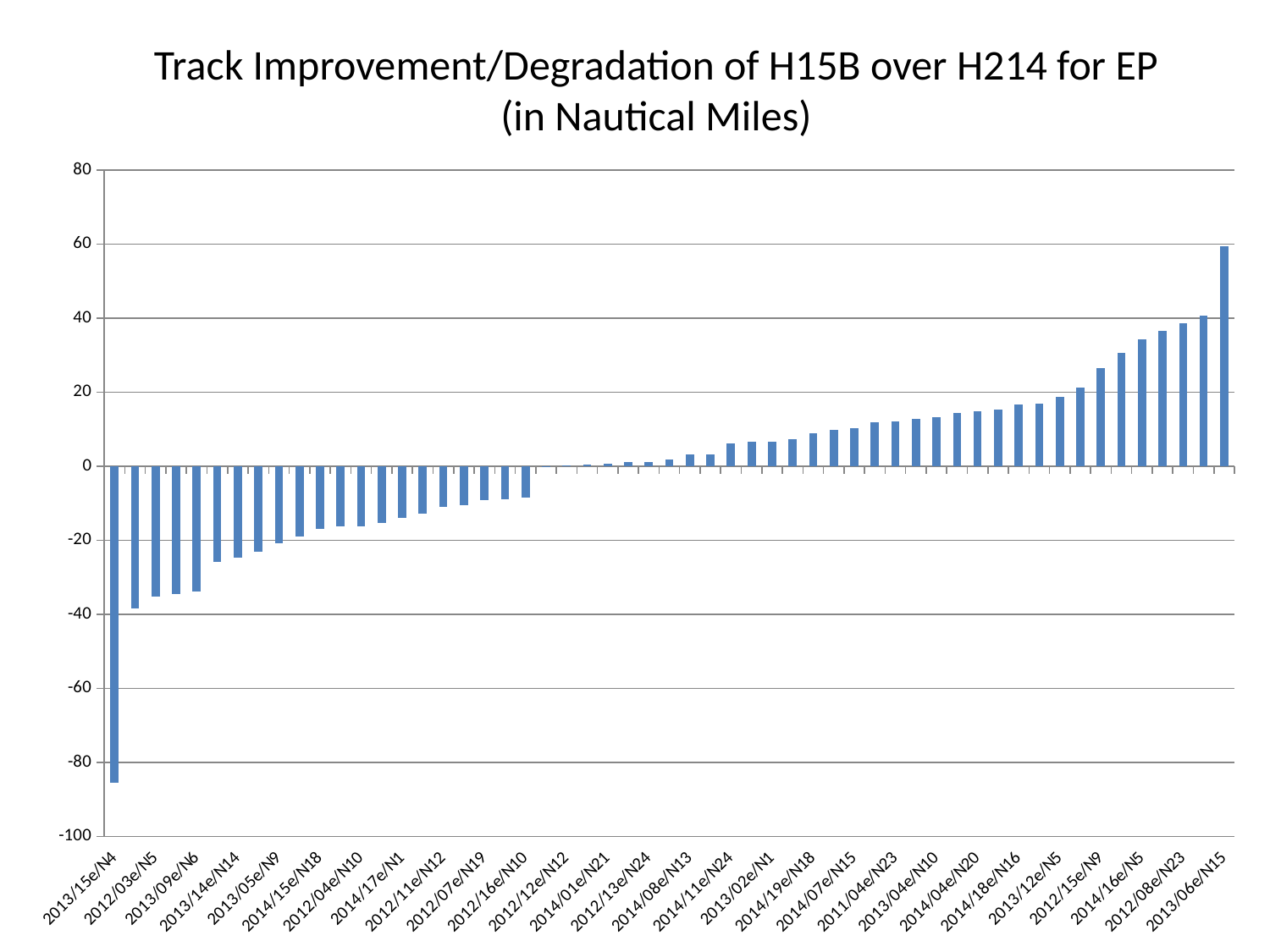
Which is larger, the value for 2013/15e/N4 or the value for 2013/06e/N15? 2013/06e/N15 What is the highest value shown on the vertical axis? 80 Is the value for 2012/08e/N23 greater or less than 20? greater Which category has the highest value? 2013/06e/N15 Is the value for 2014/07e/N15 greater or less than 20? less What kind of chart is shown on the slide? bar chart Which category has the lowest value? 2013/15e/N4 Is the value for 2012/03e/N5 greater or less than -20? less What is the title of the chart? Track Improvement/Degradation of H15B over H214 for EP (in Nautical Miles) Do the values rise or fall moving left to right along the x axis? rise